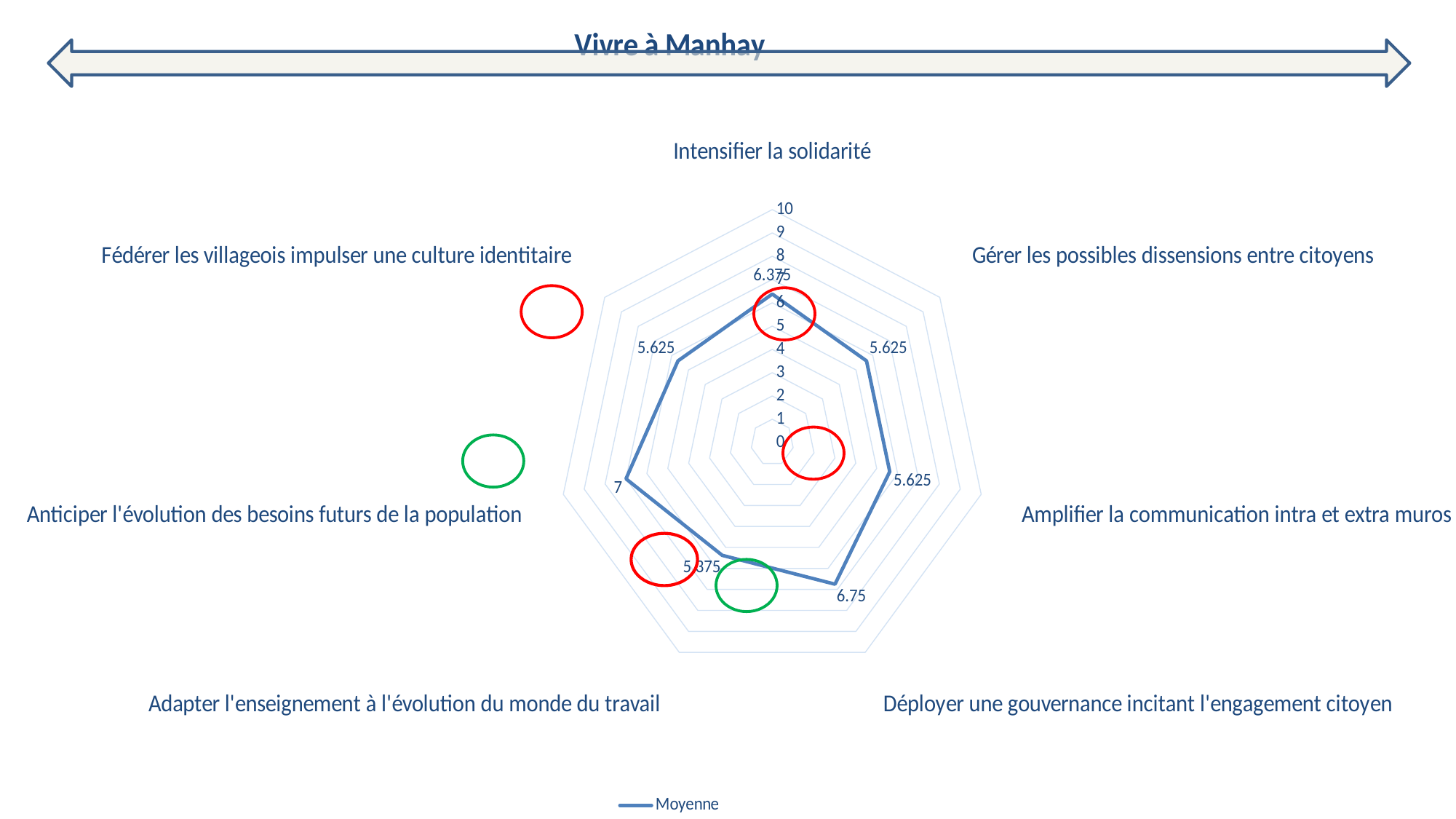
What is the value for "Déployer une gouvernance incitant l'engagement citoyen"? 6.75 What kind of chart is shown on the slide? Radar chart What is the value for "Gérer les possibles dissensions entre citoyens"? 5.625 How many categories (axes) does the radar chart have? 7 Which category has the highest value? Anticiper l'évolution des besoins futurs de la population Which category has the lowest value? Adapter l'enseignement à l'évolution du monde du travail What is the value for "Anticiper l'évolution des besoins futurs de la population"? 7 What is the difference between the values for "Anticiper l'évolution des besoins futurs de la population" and "Adapter l'enseignement à l'évolution du monde du travail"? 1.625 What is the value for "Adapter l'enseignement à l'évolution du monde du travail"? 5.375 What is the value for "Intensifier la solidarité"? 6.375 What series name is shown in the legend? Moyenne Which is larger: the value for "Déployer une gouvernance incitant l'engagement citoyen" or the value for "Intensifier la solidarité"? Déployer une gouvernance incitant l'engagement citoyen